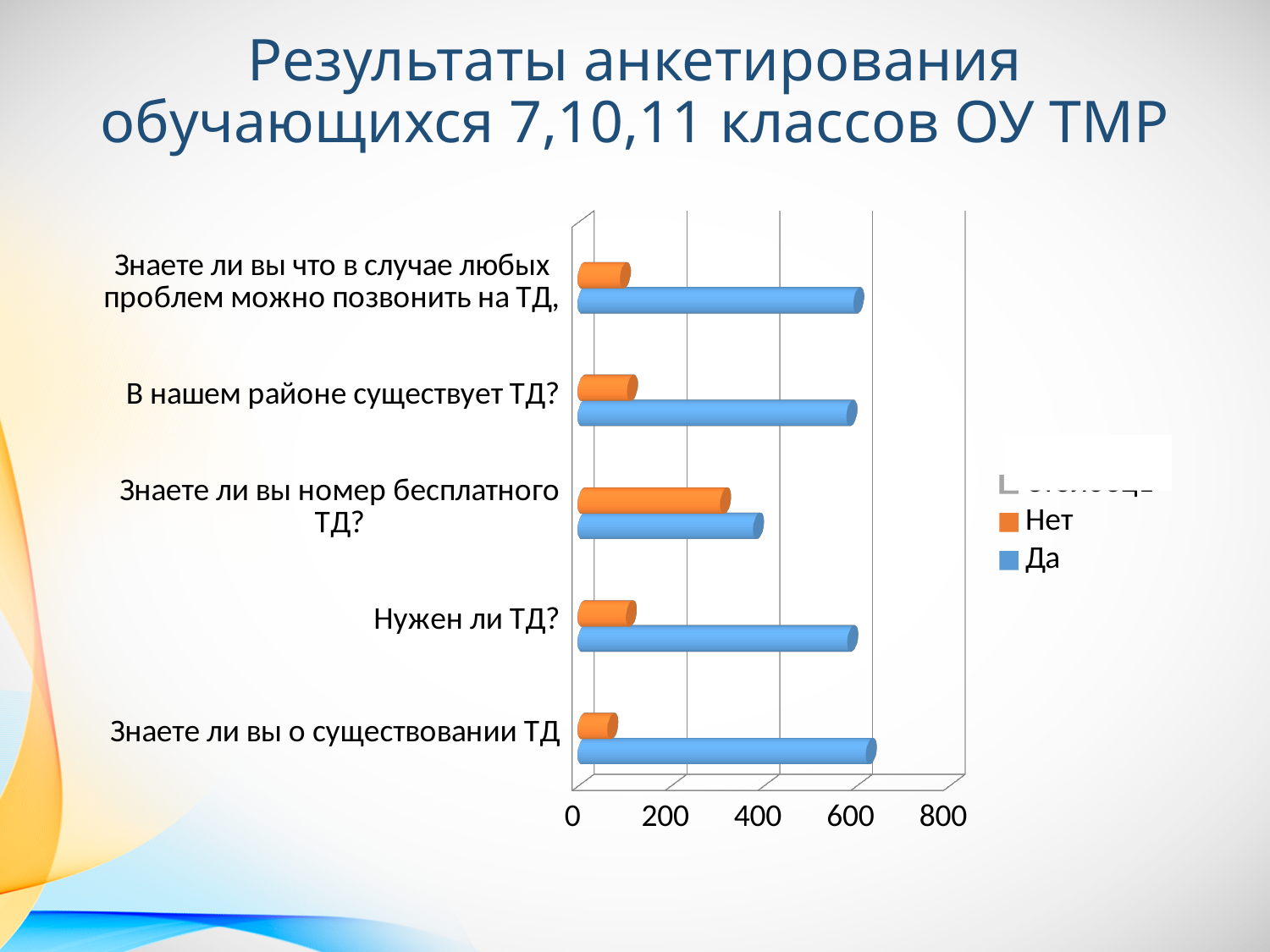
Which is larger: the "Нет" value for "Знаете ли вы номер бесплатного ТД?" or the "Нет" value for "Нужен ли ТД?"? Знаете ли вы номер бесплатного ТД? Which category has the highest value for the "Нет" series? Знаете ли вы номер бесплатного ТД? For "Знаете ли вы номер бесплатного ТД?", which is larger: the "Да" value or the "Нет" value? Да Is the "Да" value for "Нужен ли ТД?" greater or less than 400? greater What kind of chart is shown on the slide? bar chart What colour are the bars for the "Да" series? blue Which category has the lowest value for the "Да" series? Знаете ли вы номер бесплатного ТД? Is the "Да" value for "Знаете ли вы о существовании ТД" greater or less than 600? greater Is the "Нет" value for "Знаете ли вы о существовании ТД" greater or less than 200? less What is the title of the slide? Результаты анкетирования обучающихся 7,10,11 классов ОУ ТМР How many survey questions (categories) are plotted on the chart? 5